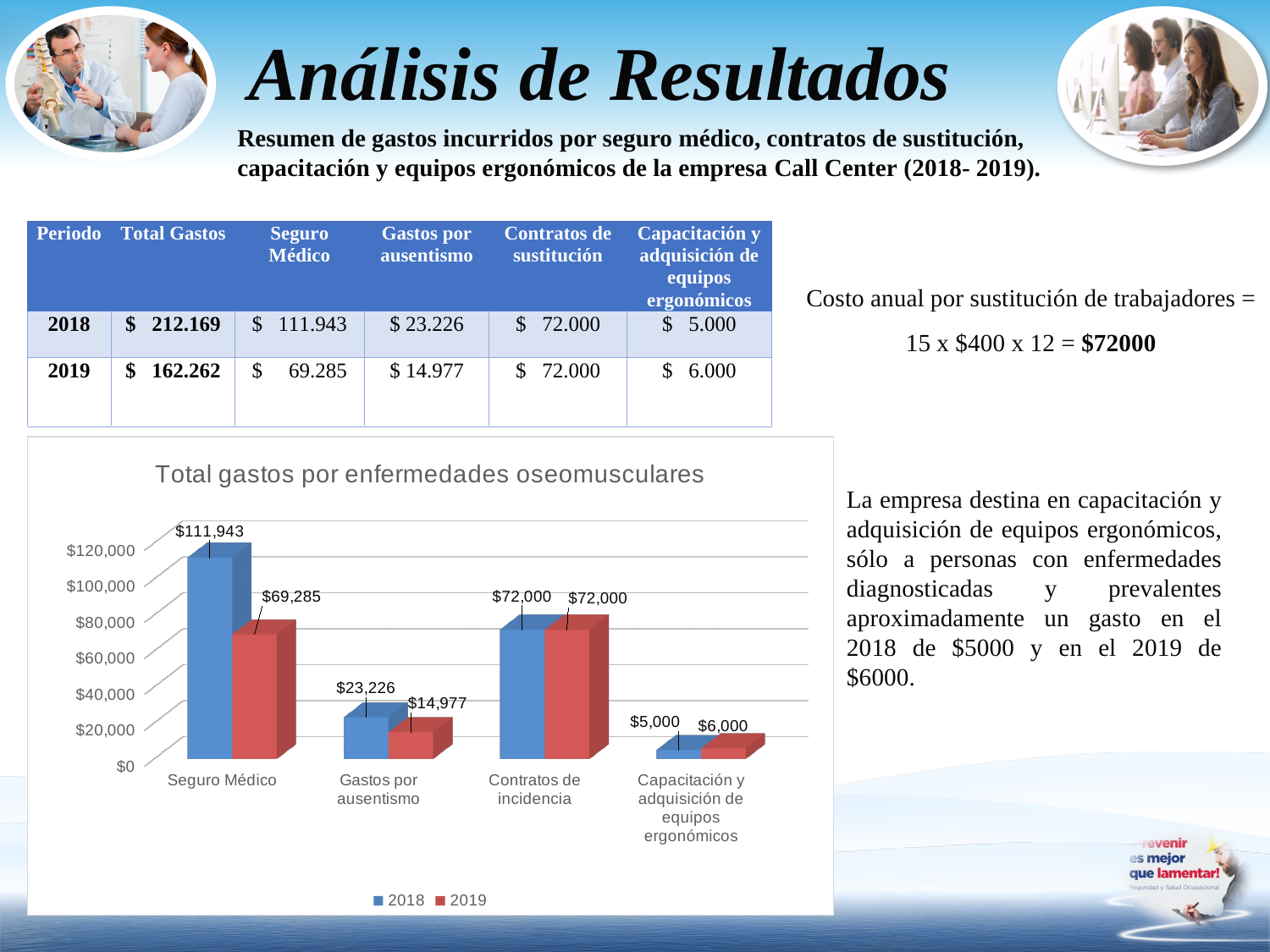
What is the value for Capacitación y adquisición de equipos ergonómicos in 2019? $6,000 Which is larger, the 2018 value for Gastos por ausentismo or the 2019 value for Gastos por ausentismo? 2018 What type of chart is shown on the slide? bar chart Which category has the highest value for 2018? Seguro Médico Which category has the lowest value for 2019? Capacitación y adquisición de equipos ergonómicos What is the value for Contratos de incidencia in 2018? $72,000 What is the difference between the 2018 and 2019 values for Seguro Médico? $42,658 What is the value for Seguro Médico in 2018? $111,943 What is the title of the chart? Total gastos por enfermedades oseomusculares What is the value for Gastos por ausentismo in 2019? $14,977 How many series does the chart legend list? 2 How many categories are shown on the x axis of the chart? 4